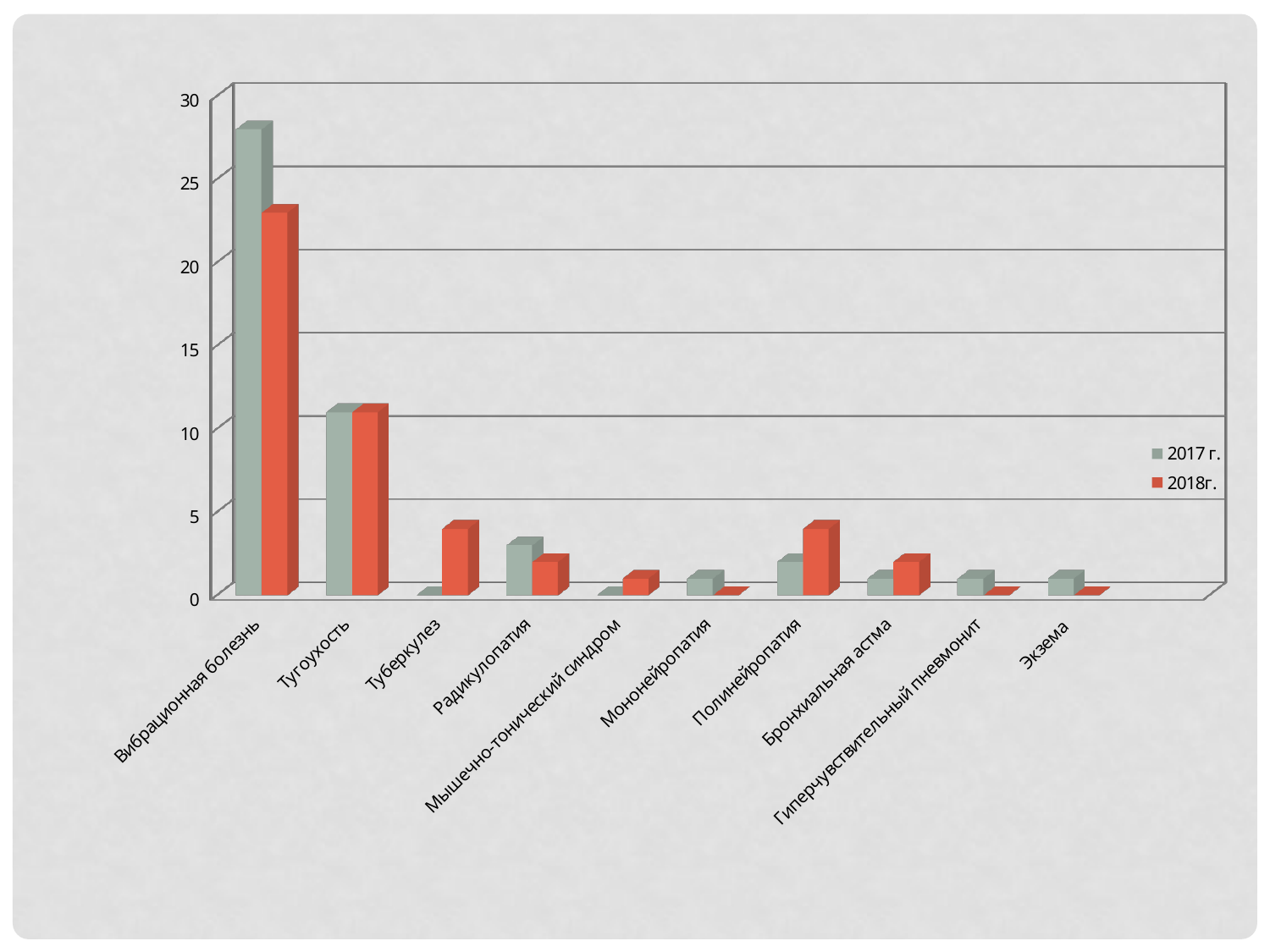
What are the two entries listed in the legend? 2017 г. and 2018г. What is the 2017 г. value for Туберкулез? 0 How many categories are shown on the x axis? 10 How many series does the legend list? 2 For Вибрационная болезнь, which series has the larger value, 2017 г. or 2018г.? 2017 г. Is the 2018г. value for Вибрационная болезнь greater or less than 25? less What kind of chart is shown on the slide? bar chart Is the 2017 г. value for Вибрационная болезнь greater or less than 25? greater For Полинейропатия, which series has the larger value, 2017 г. or 2018г.? 2018г. Which category has the highest value for the 2017 г. series? Вибрационная болезнь Is the 2017 г. value for Тугоухость greater or less than 15? less Which category has the highest value for the 2018г. series? Вибрационная болезнь